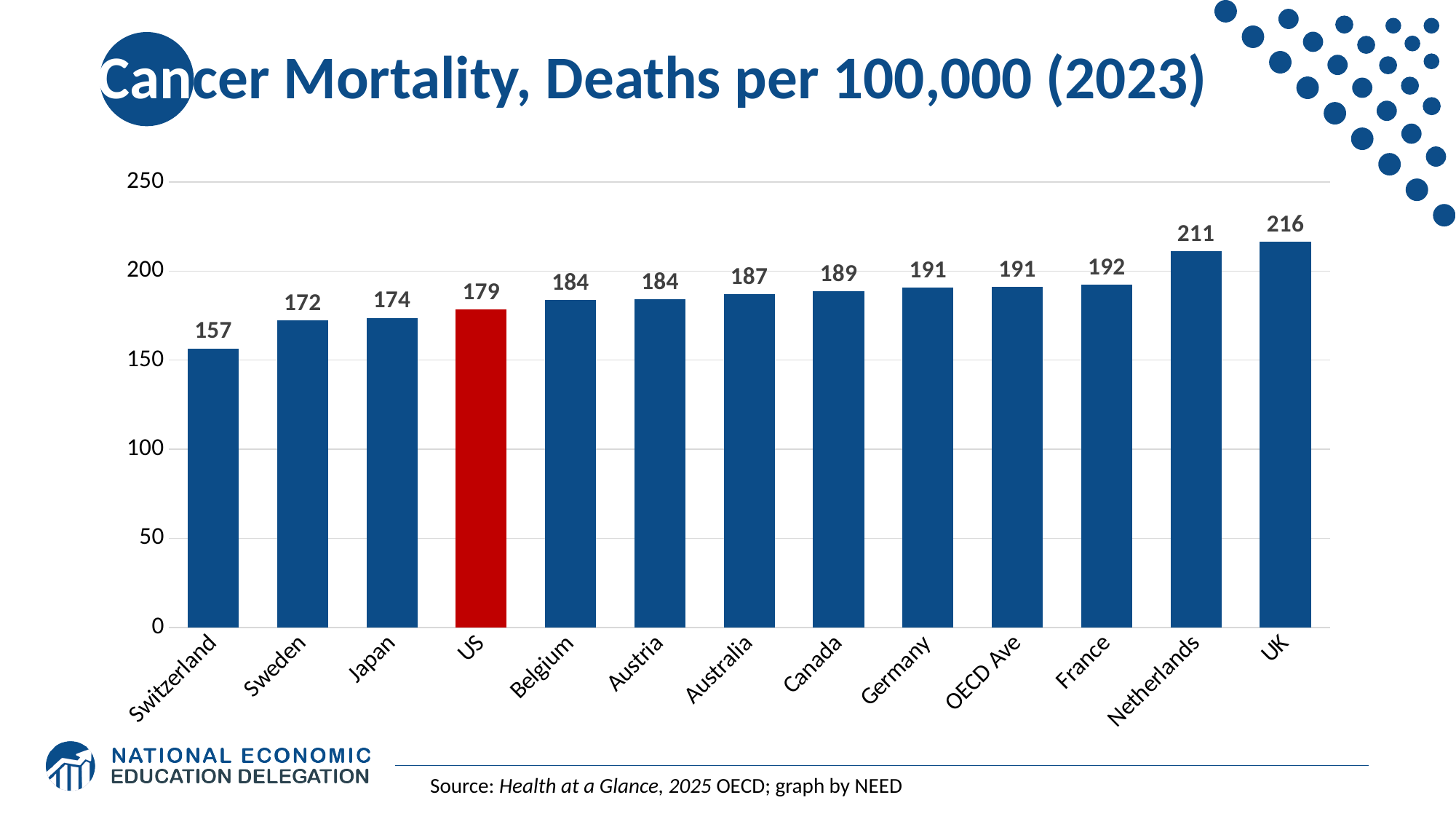
What is the value shown for Switzerland? 157 What is the difference between the OECD Ave and Switzerland? 34 Which has a higher cancer mortality rate, Netherlands or Japan? Netherlands Which bar is coloured red instead of blue? US What is the cancer mortality rate for the US? 179 Which country has the lowest cancer mortality rate on the chart? Switzerland Is the value for France greater or less than 150? greater Which country has the highest cancer mortality rate on the chart? UK What is the difference between the UK's value and the US value? 37 How many categories are shown on the x axis? 13 What is the value shown for the OECD Ave? 191 What kind of chart is shown on the slide? Bar chart